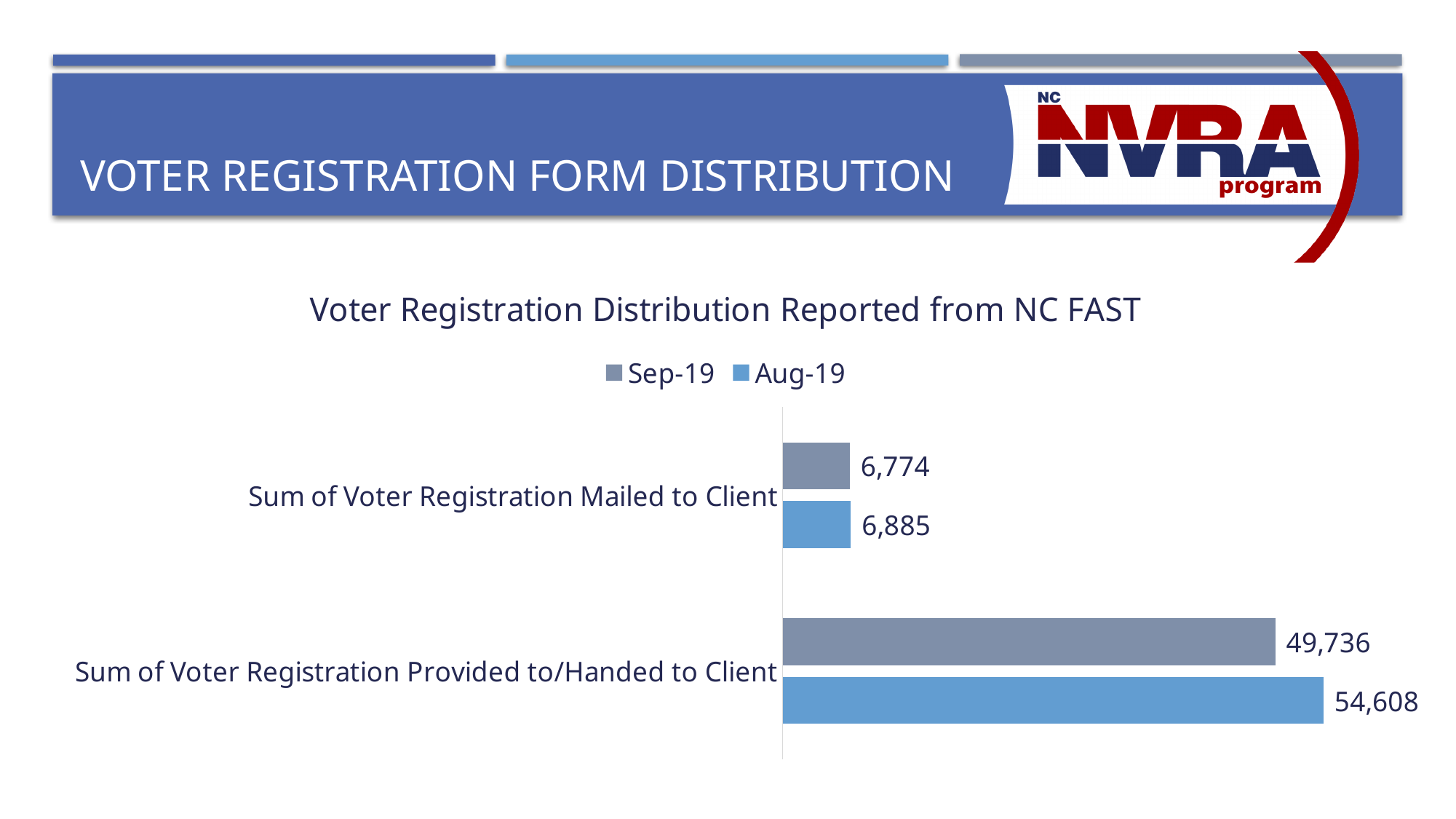
Which category has the highest Aug-19 value? Sum of Voter Registration Provided to/Handed to Client How many categories are shown in the chart? 2 What is the difference between the Aug-19 and Sep-19 values for Sum of Voter Registration Provided to/Handed to Client? 4,872 What type of chart is shown on the slide? Bar chart For Sum of Voter Registration Provided to/Handed to Client, which series has the larger value, Sep-19 or Aug-19? Aug-19 Which category has the lowest Sep-19 value? Sum of Voter Registration Mailed to Client What is the Sep-19 value for Sum of Voter Registration Provided to/Handed to Client? 49,736 How many series does the legend list? 2 What is the Aug-19 value for Sum of Voter Registration Mailed to Client? 6,885 What is the difference between the Aug-19 and Sep-19 values for Sum of Voter Registration Mailed to Client? 111 What is the Aug-19 value for Sum of Voter Registration Provided to/Handed to Client? 54,608 What is the Sep-19 value for Sum of Voter Registration Mailed to Client? 6,774